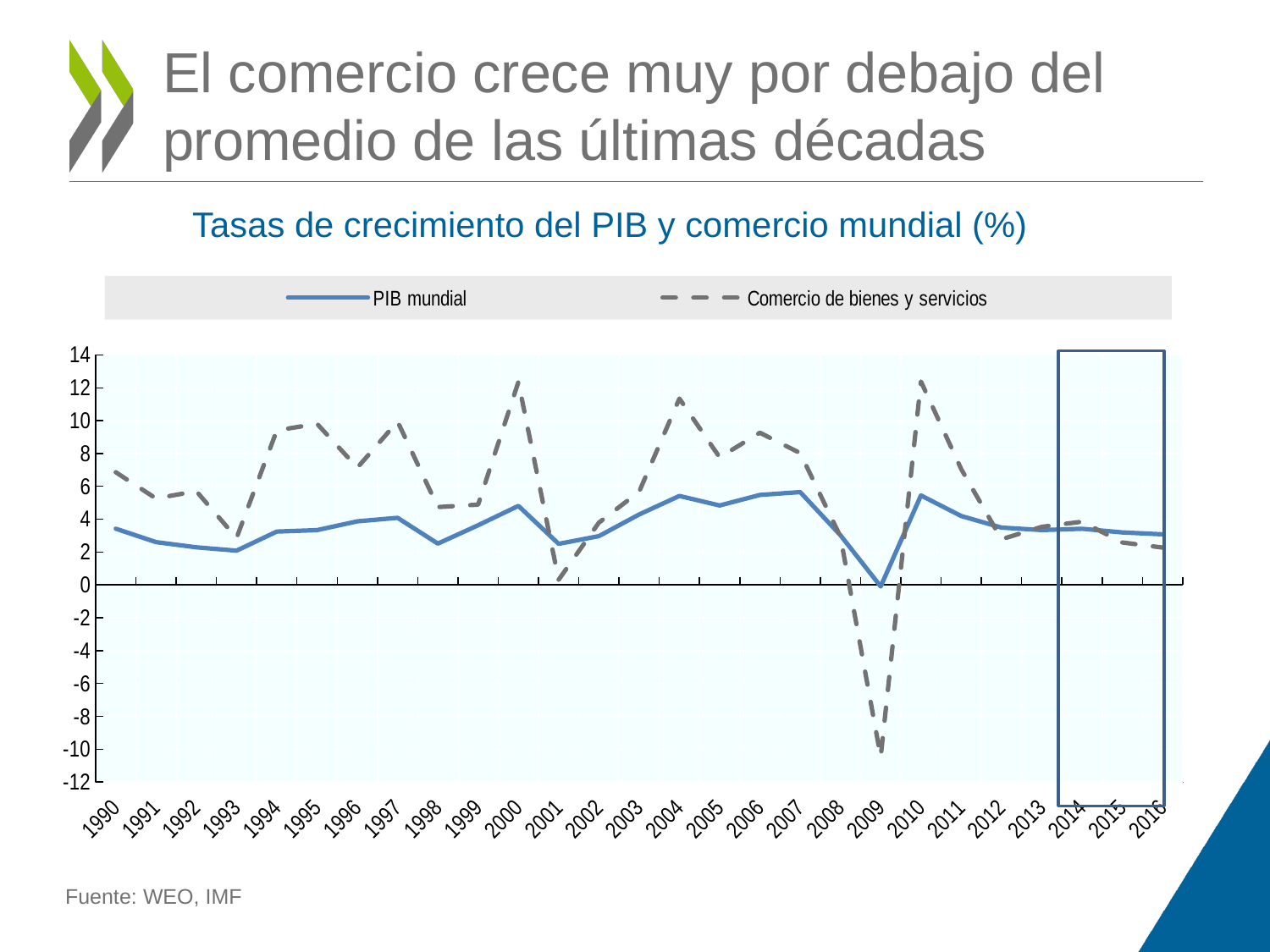
Is the value for PIB mundial in 2009 greater or less than 2? less How many years are shown along the x axis? 27 What kind of chart is shown on the slide? line chart What is the title of the chart? Tasas de crecimiento del PIB y comercio mundial (%) In 2009, which series has the larger value, PIB mundial or Comercio de bienes y servicios? PIB mundial In which year does the Comercio de bienes y servicios series reach its lowest value? 2009 Is the value for Comercio de bienes y servicios in 2000 greater or less than 10? greater In 2004, which series has the larger value, PIB mundial or Comercio de bienes y servicios? Comercio de bienes y servicios How many series does the legend list? 2 Is the value for Comercio de bienes y servicios in 2001 greater or less than 2? less In which year does the PIB mundial series reach its lowest value? 2009